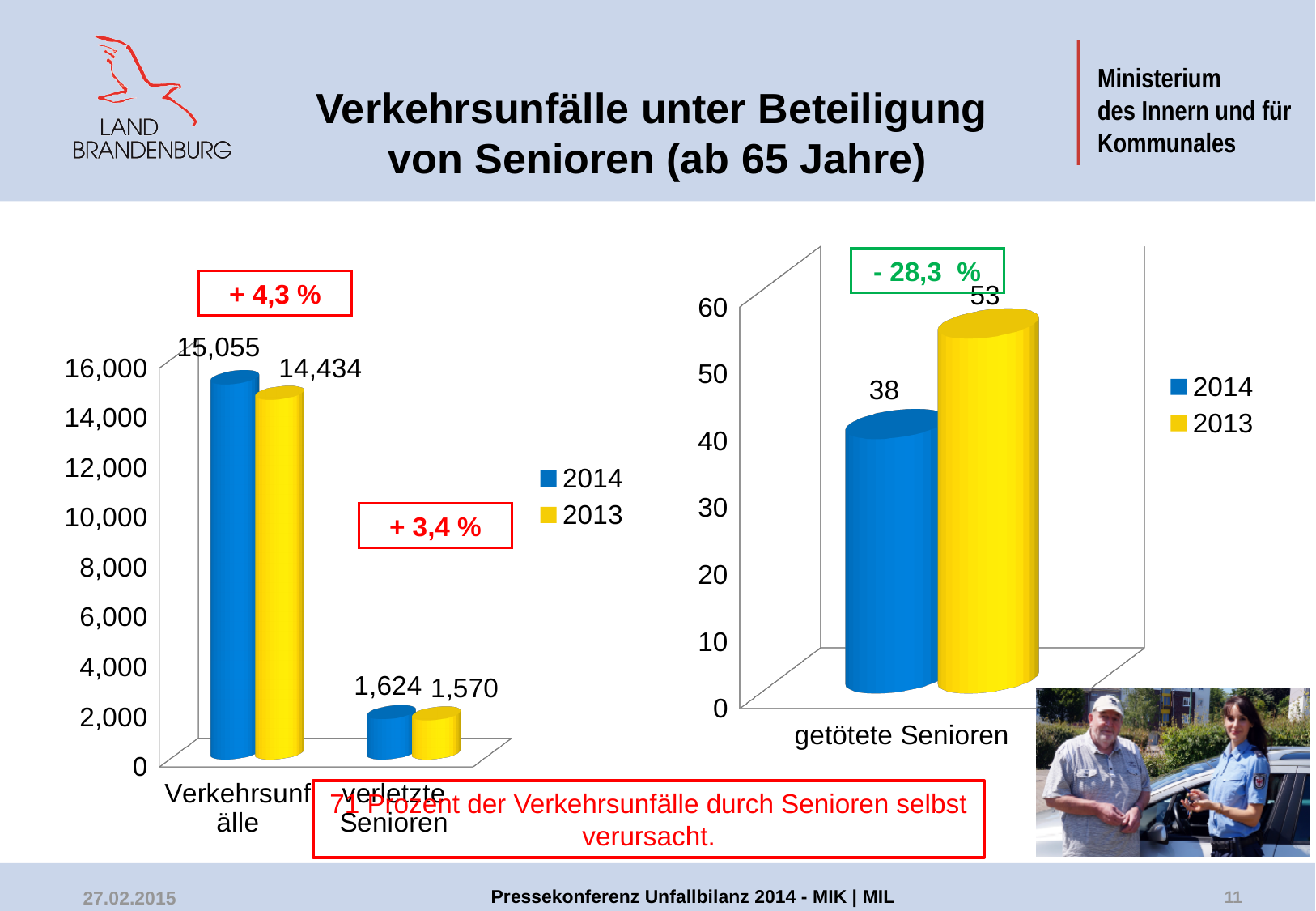
In the left chart, what is the value for verletzte Senioren in 2014? 1,624 In the right chart, what is the value for getötete Senioren in 2014? 38 In the right chart, what is the value for getötete Senioren in 2013? 53 How many series does the legend of the left chart list? 2 In the right chart, what is the difference between the 2013 and 2014 values for getötete Senioren? 15 In the left chart, what is the value for Verkehrsunfälle in 2014? 15,055 In the left chart, what is the difference between the 2014 and 2013 values for Verkehrsunfälle? 621 What kind of chart is the right chart? Bar chart In the right chart, which year has the larger value for getötete Senioren, 2014 or 2013? 2013 In the left chart, which year has the larger value for verletzte Senioren, 2014 or 2013? 2014 In the left chart, what is the value for verletzte Senioren in 2013? 1,570 In the left chart, what is the value for Verkehrsunfälle in 2013? 14,434